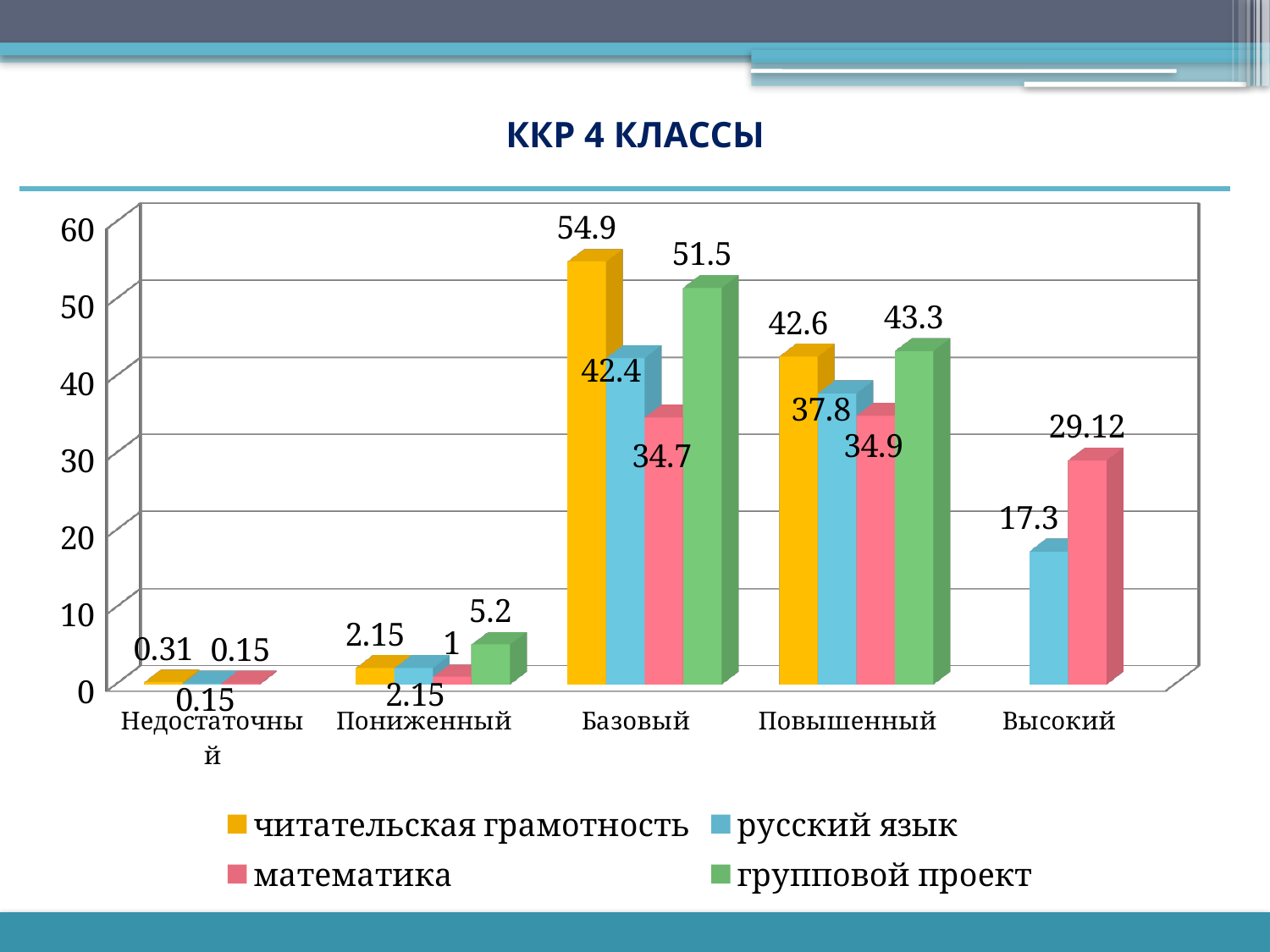
Which category has the highest value for читательская грамотность? Базовый What is the value for математика in the Высокий category? 29.12 In the Повышенный category, which is larger: читательская грамотность or русский язык? читательская грамотность What is the value for читательская грамотность in the Базовый category? 54.9 What kind of chart is shown on the slide? bar chart What is the difference between читательская грамотность and математика in the Базовый category? 20.2 What is the value for русский язык in the Высокий category? 17.3 Is the value for групповой проект in the Базовый category greater or less than 50? greater Which category has the lowest value for групповой проект? Пониженный What is the value for групповой проект in the Повышенный category? 43.3 How many series does the legend list? 4 How many categories are shown on the x axis? 5